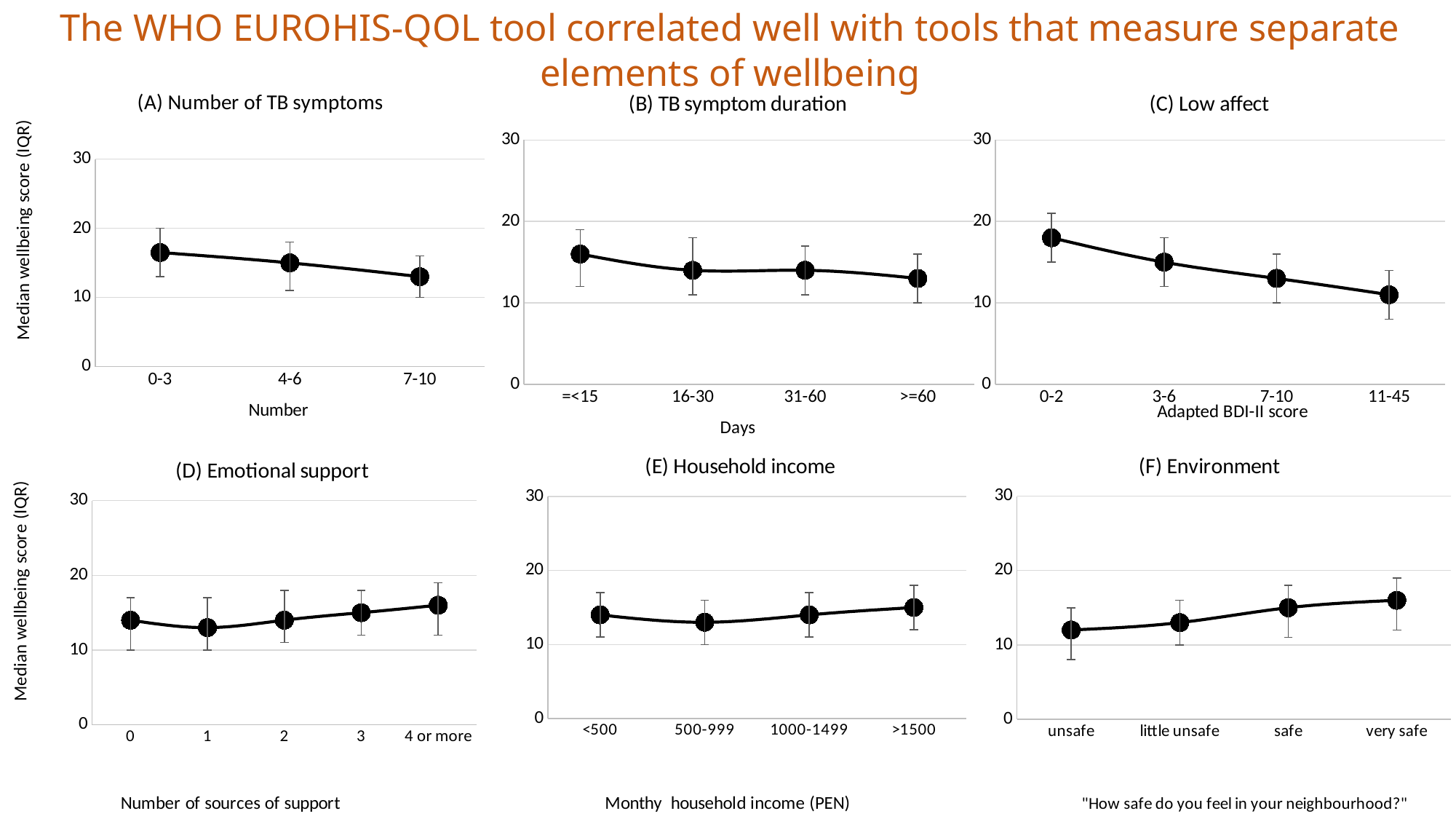
In chart (D) Emotional support, how many categories are plotted on the x axis? 5 In chart (F) Environment, is the value for unsafe greater or less than 10? greater In chart (C) Low affect, is the value for 0-2 greater or less than 20? less In chart (A) Number of TB symptoms, do the values rise or fall as the number of symptoms increases? fall In chart (B) TB symptom duration, which category has the highest median wellbeing score? =<15 In chart (A) Number of TB symptoms, which category has the highest median wellbeing score? 0-3 In chart (C) Low affect, how many categories are plotted on the x axis? 4 In chart (C) Low affect, which category has the lowest median wellbeing score? 11-45 What kind of chart is (A) Number of TB symptoms? line chart In chart (F) Environment, do the values rise or fall from unsafe to very safe? rise In chart (A) Number of TB symptoms, how many categories are plotted on the x axis? 3 How many charts are shown on the slide? 6